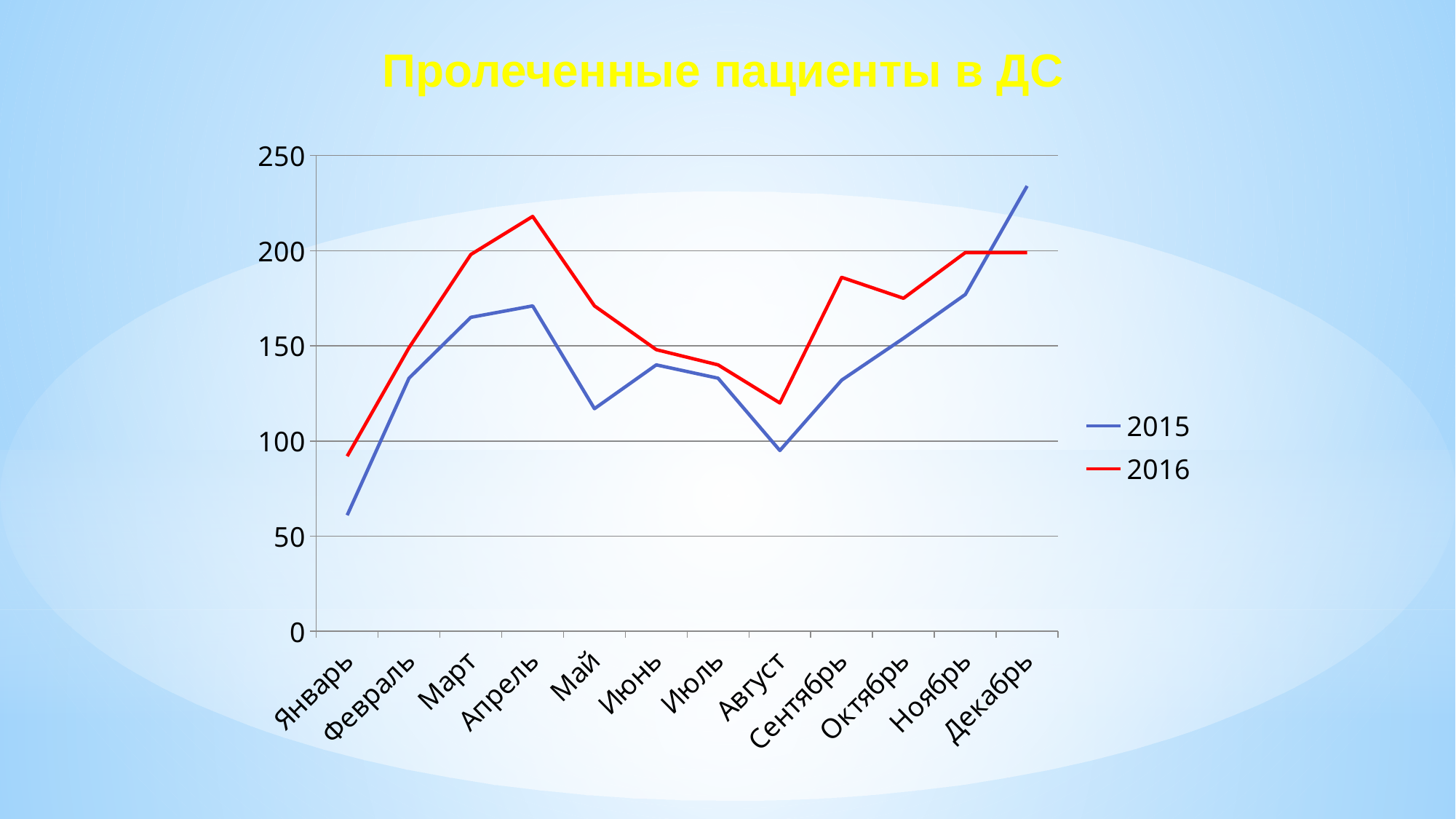
In Апрель, which series has the larger value, 2015 or 2016? 2016 What is the title of the chart? Пролеченные пациенты в ДС In which month does the 2015 series have its lowest value? Январь What kind of chart is shown on the slide? line chart Is the 2015 value for Декабрь greater or less than 200? greater How many series does the legend list? 2 In Декабрь, which series has the larger value, 2015 or 2016? 2015 In which month does the 2016 series reach its highest value? Апрель In which month does the 2015 series reach its highest value? Декабрь Is the 2015 value for Август greater or less than 100? less In which month does the 2016 series have its lowest value? Январь How many months are plotted along the x axis? 12